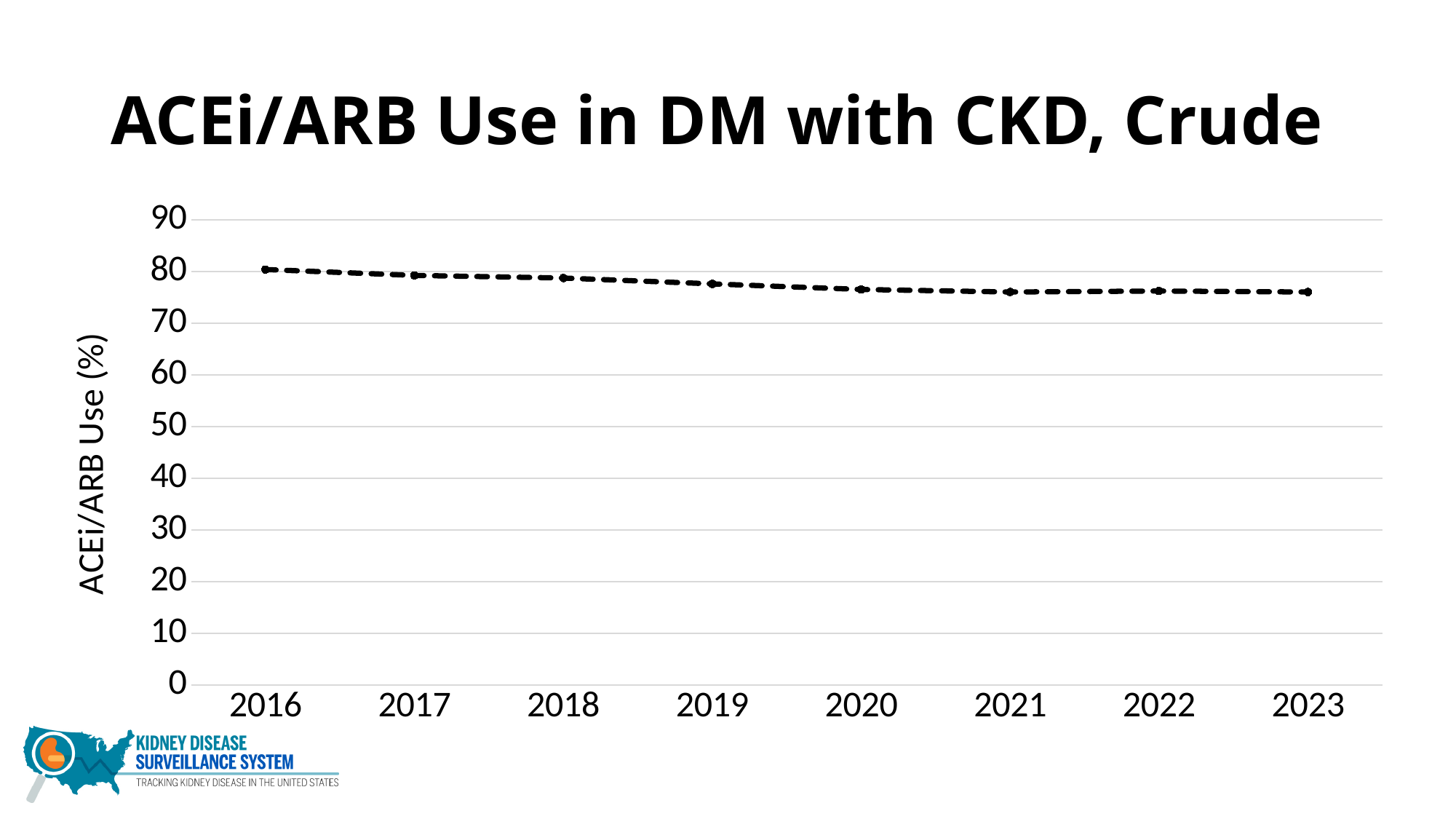
Which is larger, the value for 2016 or the value for 2023? 2016 Is the value for 2020 greater or less than 70? greater Which is larger, the value for 2017 or the value for 2021? 2017 What is the label on the vertical axis of the chart? ACEi/ARB Use (%) Is the value for 2016 greater or less than 70? greater Which year has the highest ACEi/ARB use? 2016 How many years are plotted along the x axis? 8 Do the values rise or fall from 2016 to 2023? fall What is the title of the chart? ACEi/ARB Use in DM with CKD, Crude Is the value for 2023 greater or less than 80? less What kind of chart is shown on the slide? line chart